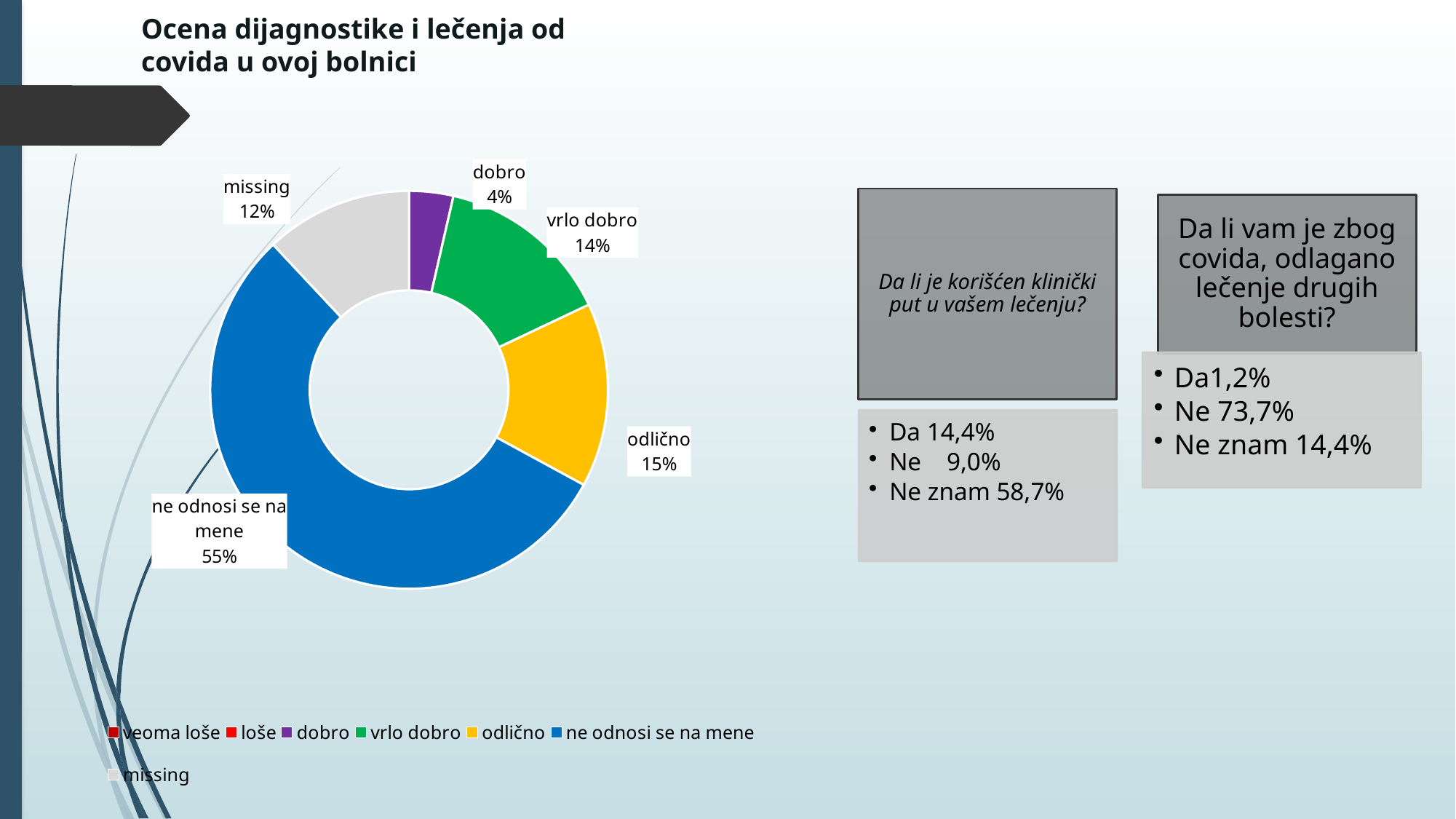
What percentage does the 'missing' slice show? 12% What percentage does the 'ne odnosi se na mene' slice show? 55% Which labelled slice has the smallest percentage? dobro What percentage does the 'vrlo dobro' slice show? 14% What is the difference in percentage points between 'ne odnosi se na mene' and 'odlično'? 40 How many entries does the chart legend list? 7 What percentage does the 'odlično' slice show? 15% What type of chart is shown on the slide? doughnut (pie) chart What colour is the 'odlično' slice? yellow How many slices with data labels are shown in the chart? 5 Which slice is larger, 'vrlo dobro' or 'missing'? vrlo dobro Which category has the largest slice in the chart? ne odnosi se na mene